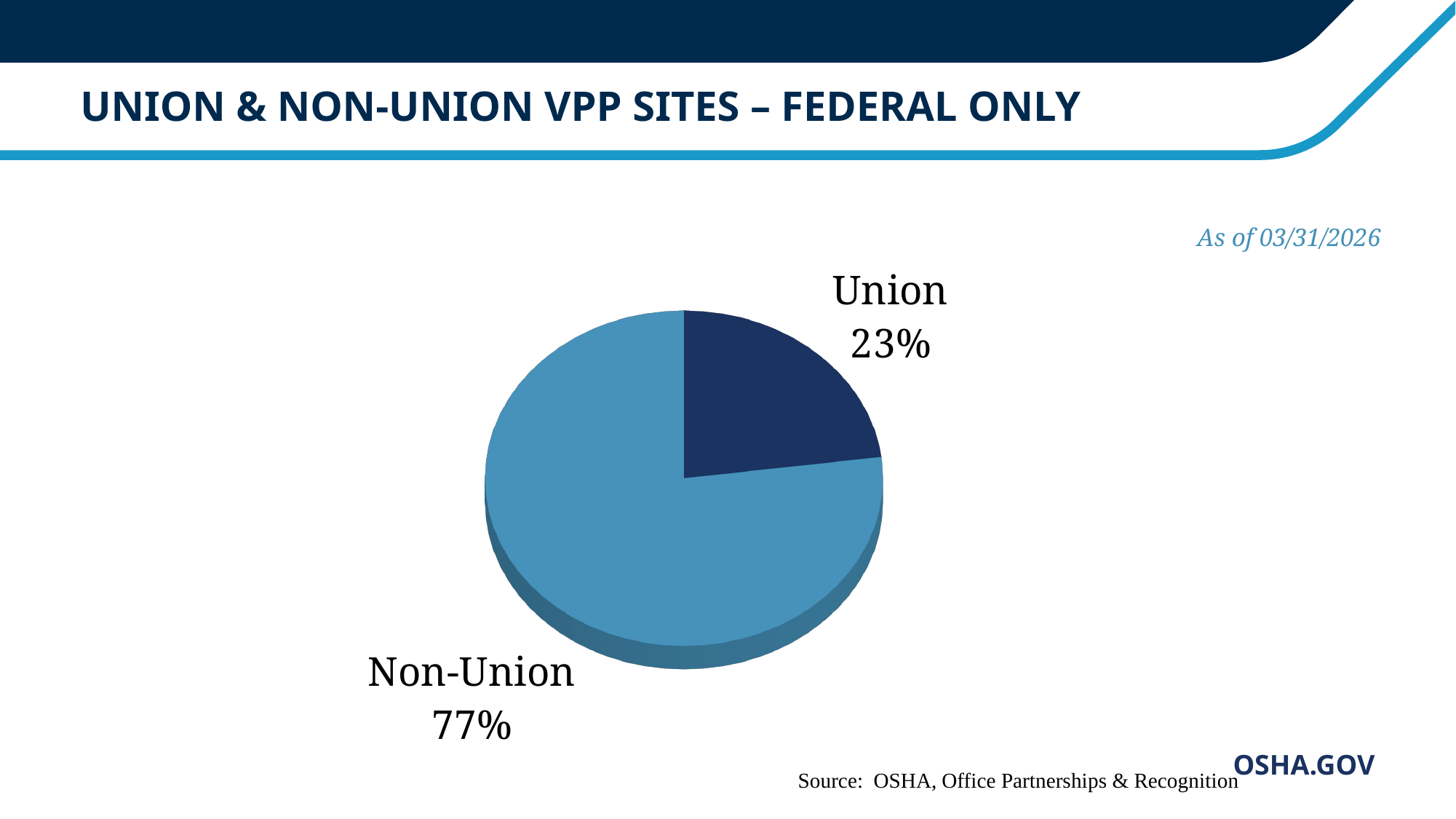
What kind of chart is shown on the slide? Pie chart What is the difference in percentage points between the Non-Union and Union shares? 54 What share of the pie does the Union slice represent? 23% As of what date is the chart data reported? 03/31/2026 Which is larger, the Union share or the Non-Union share? Non-Union Which category has the largest share of the pie? Non-Union What percentage of federal VPP sites are Union? 23% What is the title of the chart on the slide? Union & Non-Union VPP Sites – Federal Only Which category has the smallest share of the pie? Union How many categories are shown in the pie chart? 2 What percentage of federal VPP sites are Non-Union? 77%